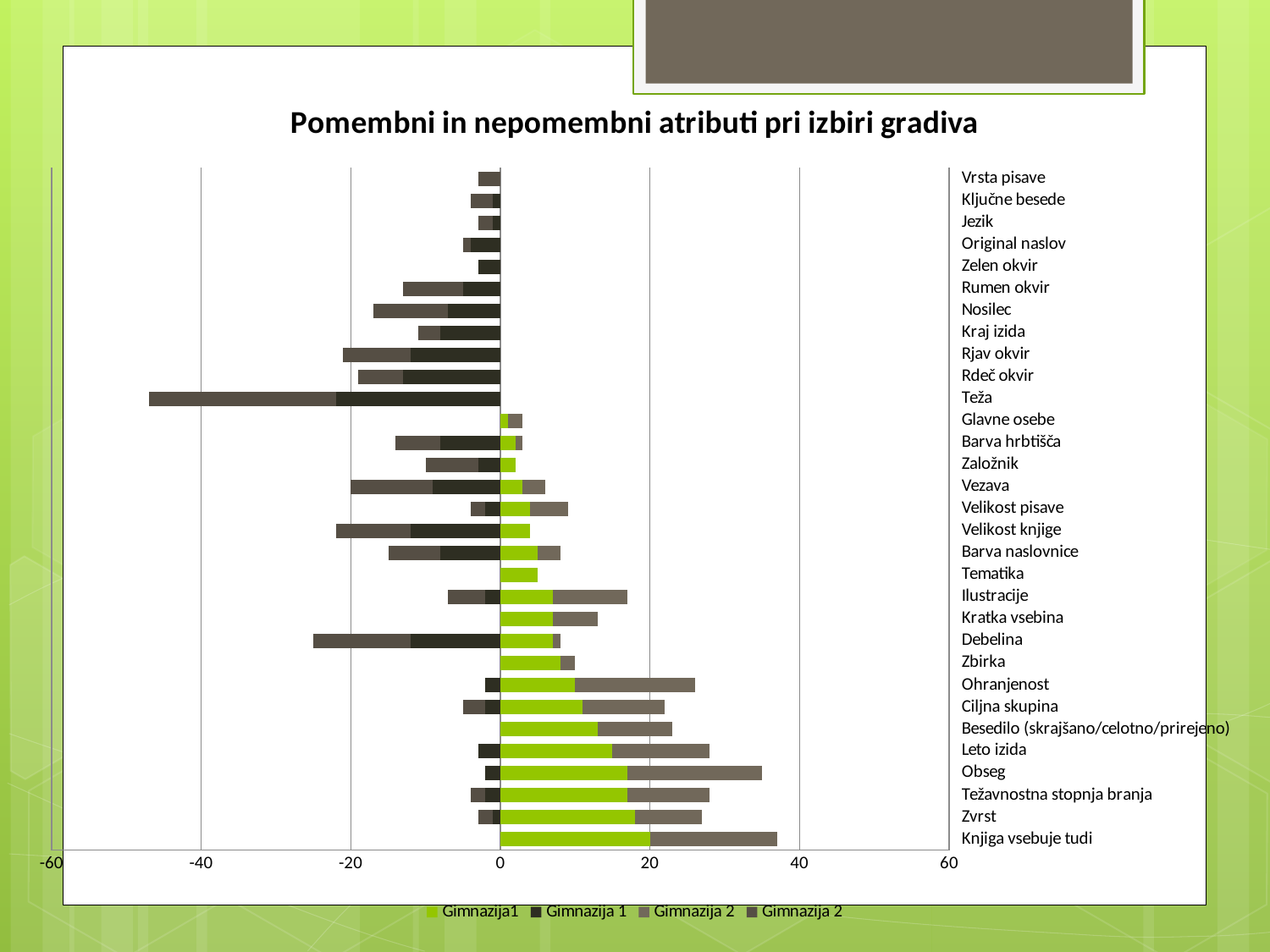
Is the negative stacked bar for Teža less or greater than -40? less How many categories are plotted on the chart? 31 Is the positive stacked bar for Knjiga vsebuje tudi greater or less than 20? greater How many series does the legend list? 4 Which has the longer negative stacked bar, Teža or Vrsta pisave? Teža Is the positive stacked bar for Glavne osebe greater or less than 20? less What is the title of the chart? Pomembni in nepomembni atributi pri izbiri gradiva What kind of chart is shown on the slide? bar chart What is the lowest value shown on the horizontal axis? -60 Which has the longer positive stacked bar, Obseg or Založnik? Obseg Which category has the bar extending furthest into negative values? Teža